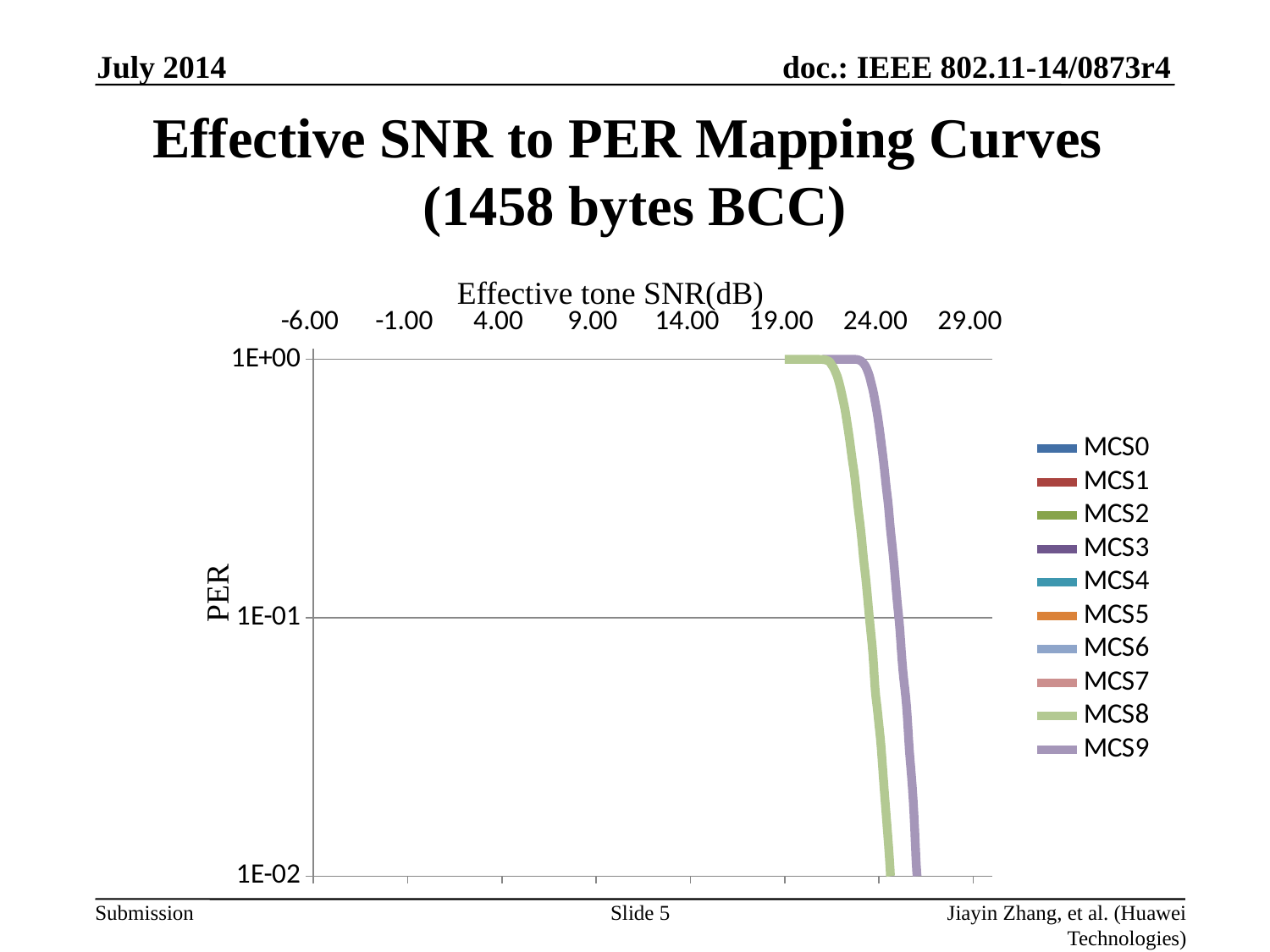
What is the lowest PER value shown on the vertical axis? 1E-02 What is the label of the horizontal axis? Effective tone SNR(dB) As the effective tone SNR increases, does the PER of the plotted curves rise or fall? fall What kind of chart is shown on the slide? line chart Is the effective tone SNR at which the MCS9 curve reaches a PER of 1E-01 greater or less than 24.00? greater What is the highest effective tone SNR value labelled on the horizontal axis? 29.00 How many series does the legend list? 10 Is the effective tone SNR at which the MCS9 curve reaches a PER of 1E-02 greater or less than 29.00? less What is the label of the vertical axis? PER Which legend entry is the last one listed? MCS9 Is the effective tone SNR at which the MCS8 curve reaches a PER of 1E-01 greater or less than 19.00? greater Which curve reaches a PER of 1E-01 at a higher effective tone SNR, MCS8 or MCS9? MCS9